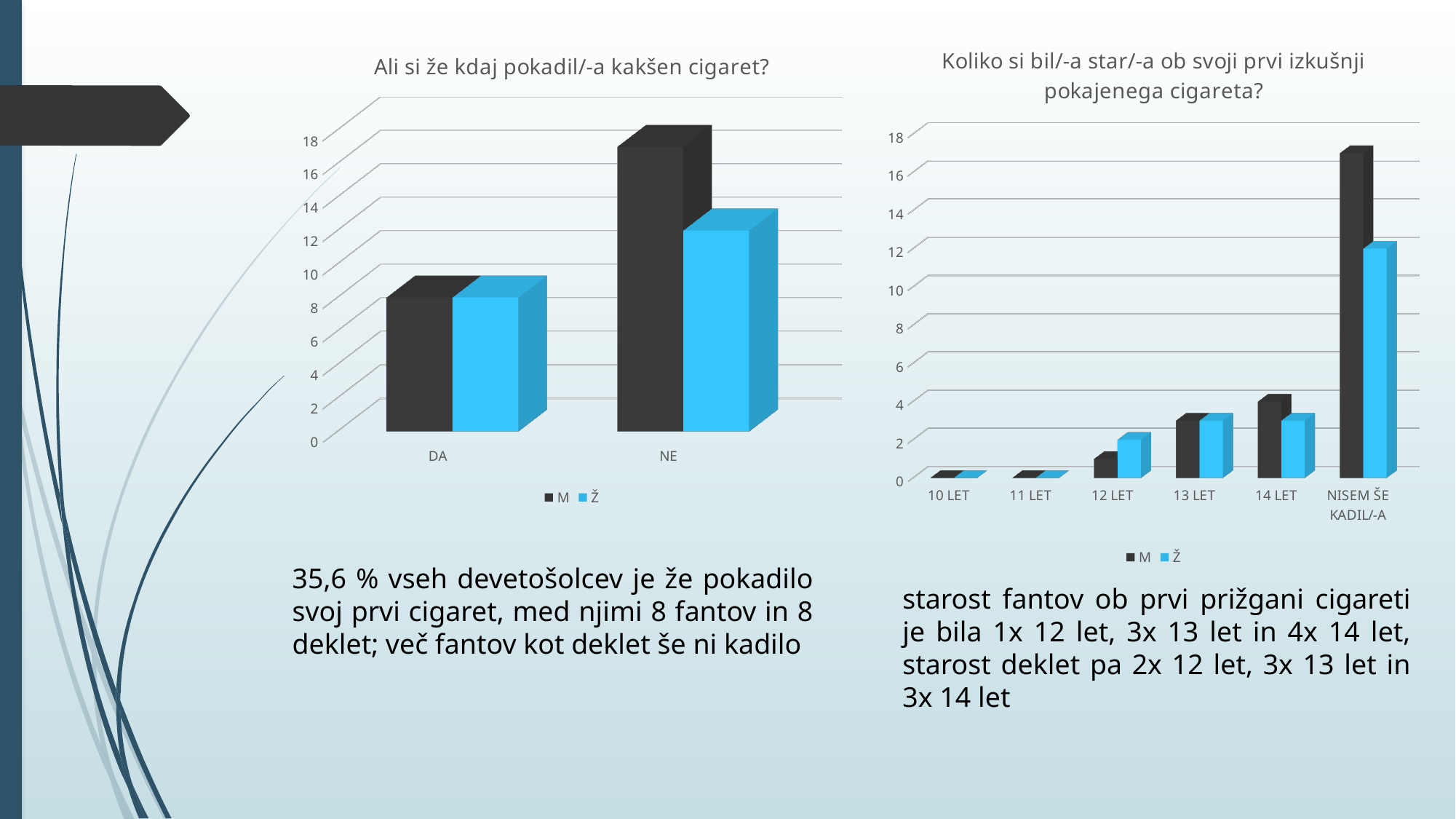
In the left chart "Ali si že kdaj pokadil/-a kakšen cigaret?", which series has the higher value in the NE category, M or Ž? M In the right chart "Koliko si bil/-a star/-a ob svoji prvi izkušnji pokajenega cigareta?", which series has the higher value in the 12 LET category, M or Ž? Ž In the right chart "Koliko si bil/-a star/-a ob svoji prvi izkušnji pokajenega cigareta?", is the value for M in the NISEM ŠE KADIL/-A category greater or less than 16? greater In the left chart "Ali si že kdaj pokadil/-a kakšen cigaret?", is the value for M in the NE category greater or less than 14? greater In the left chart "Ali si že kdaj pokadil/-a kakšen cigaret?", how many categories are shown on the x axis? 2 In the right chart "Koliko si bil/-a star/-a ob svoji prvi izkušnji pokajenega cigareta?", how many categories are shown on the x axis? 6 In the left chart "Ali si že kdaj pokadil/-a kakšen cigaret?", is the value for Ž in the NE category greater or less than 10? greater What type of chart is the left chart titled "Ali si že kdaj pokadil/-a kakšen cigaret?"? bar chart How many series does the legend of the left chart "Ali si že kdaj pokadil/-a kakšen cigaret?" list? 2 In the left chart "Ali si že kdaj pokadil/-a kakšen cigaret?", which category has the higher value for M, DA or NE? NE In the right chart "Koliko si bil/-a star/-a ob svoji prvi izkušnji pokajenega cigareta?", which category has the highest value for M? NISEM ŠE KADIL/-A In the right chart "Koliko si bil/-a star/-a ob svoji prvi izkušnji pokajenega cigareta?", what colour are the bars for the Ž series? light blue